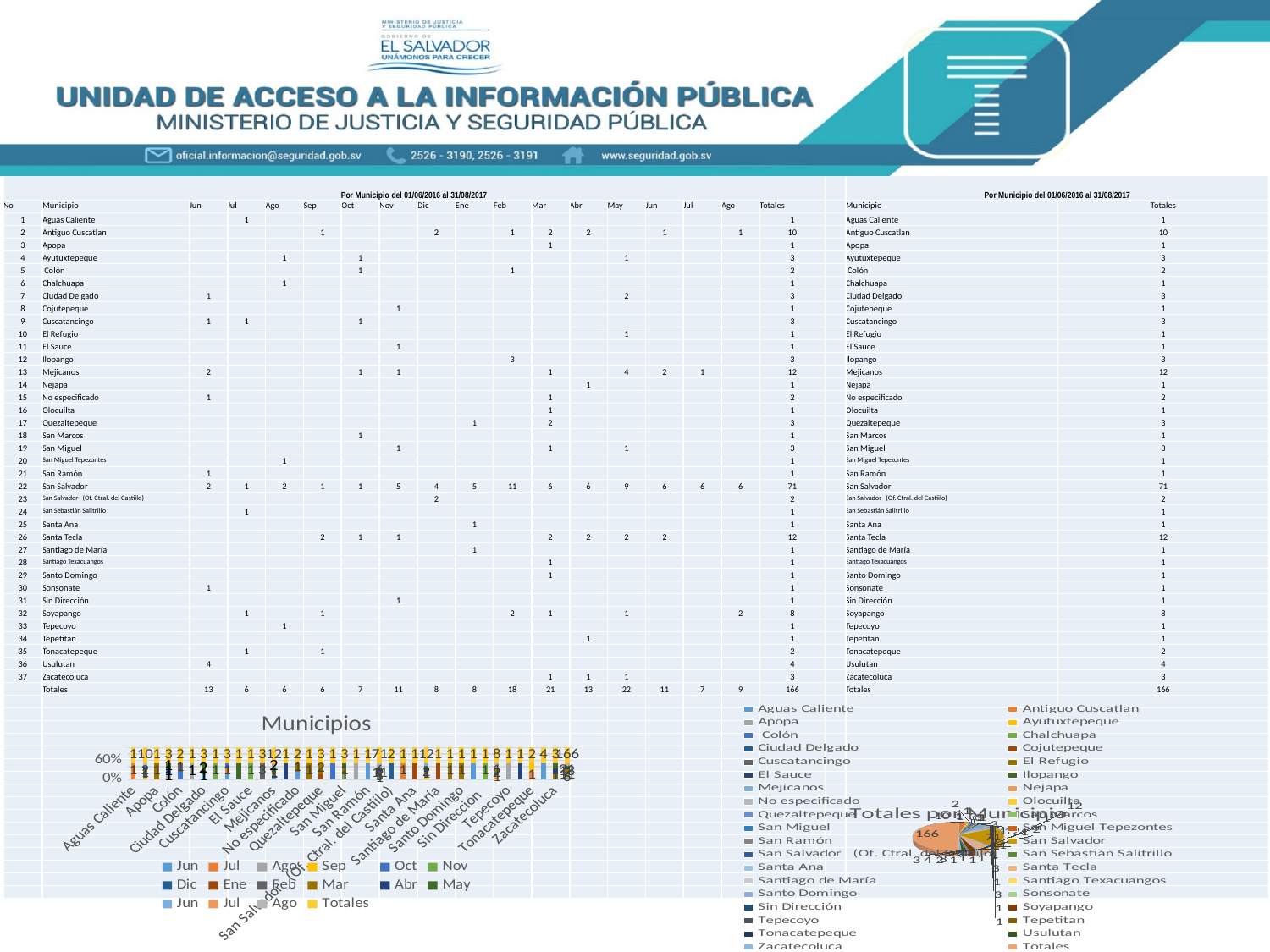
What is the title of the bar chart at the bottom left of the slide? Municipios In the "Totales por Municipio" pie chart, what value is printed on the largest slice? 166 In the "Totales por Municipio" pie chart, which legend entry corresponds to the largest slice? Totales How many entries does the legend of the "Totales por Municipio" pie chart list? 38 What is the title of the pie chart at the bottom right of the slide? Totales por Municipio What kind of chart is the "Totales por Municipio" chart at the bottom right of the slide? pie chart What kind of chart is the "Municipios" chart at the bottom left of the slide? bar chart How many entries does the legend of the "Municipios" bar chart list? 16